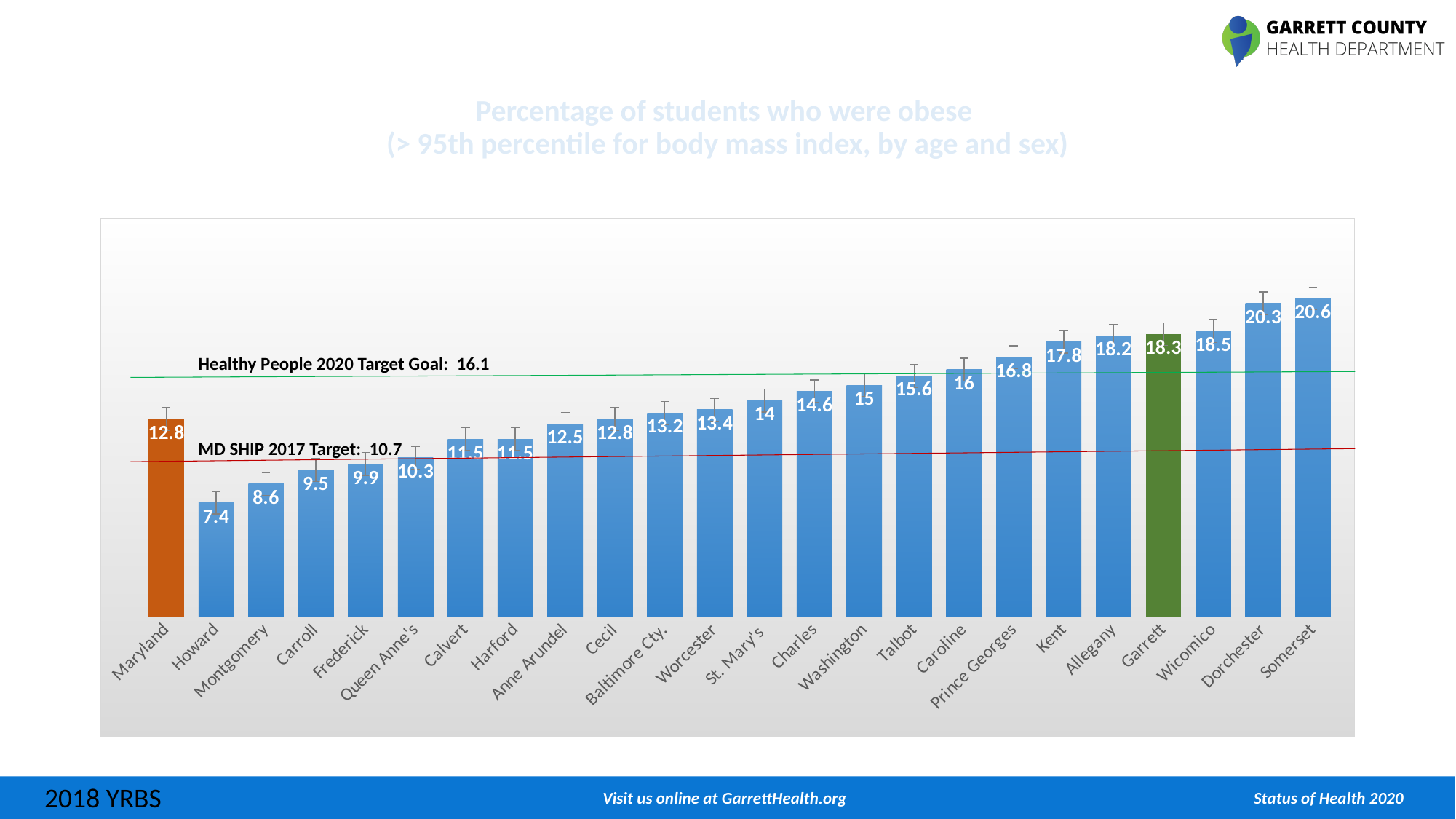
What is the difference between the values for Garrett and Maryland? 5.5 How many bars are plotted on the chart? 24 Do the values generally rise or fall from left to right across the counties after Maryland? Rise Which county has the highest percentage of obese students? Somerset What is the value for Maryland? 12.8 Which is larger, the value for Kent or the value for Allegany? Allegany Which county has the lowest percentage of obese students? Howard What kind of chart is shown on the slide? Bar chart What is the Healthy People 2020 Target Goal shown on the chart? 16.1 What colour is the bar for Garrett? Green What is the value for Garrett? 18.3 What is the value for Prince Georges? 16.8